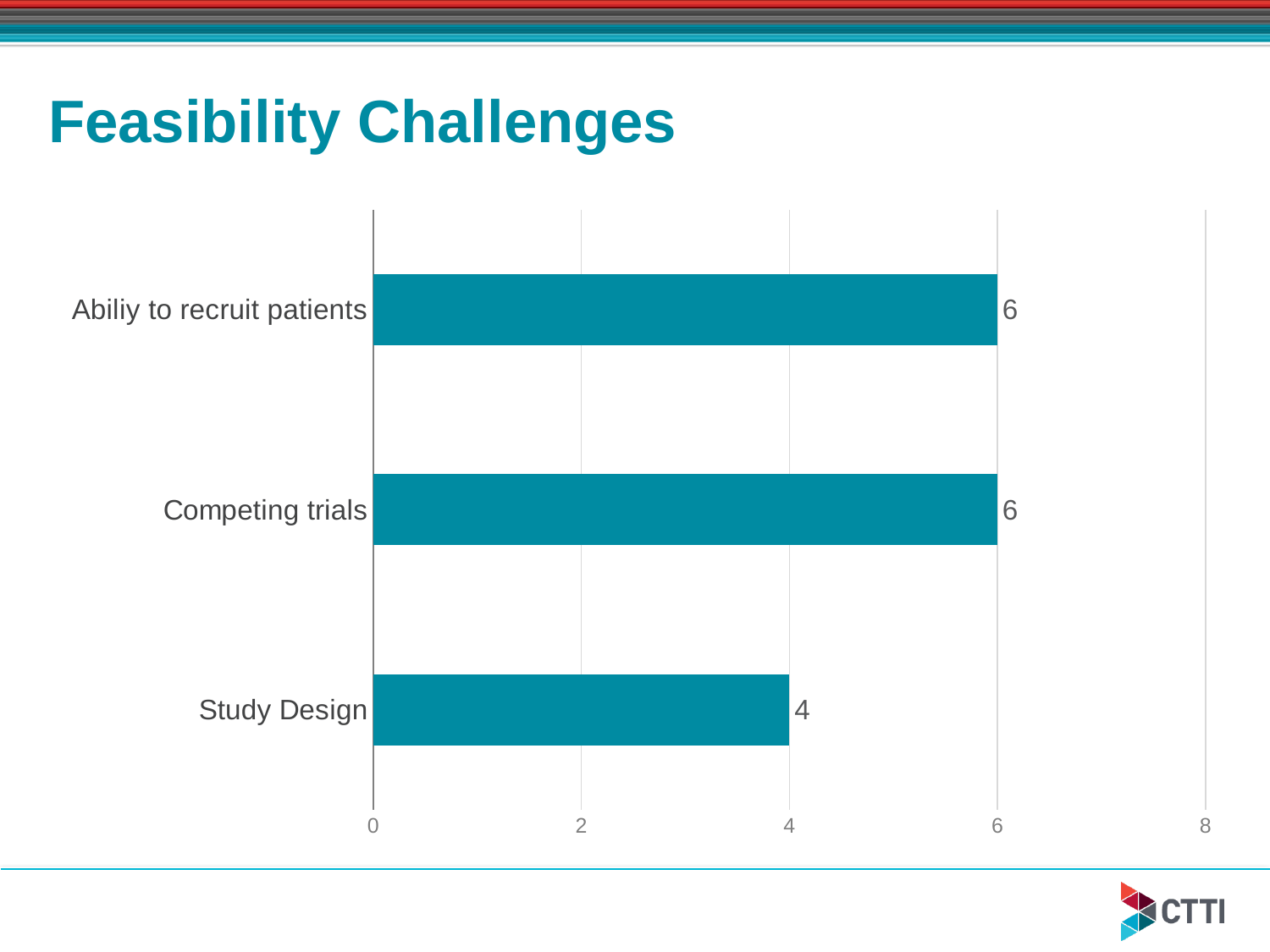
Which category has the lowest value? Study Design Is the value for Study Design greater or less than 6? less What kind of chart is shown on the slide? bar chart What is the value for Abiliy to recruit patients? 6 What is the value for Competing trials? 6 What is the title of the slide? Feasibility Challenges What is the maximum value shown on the horizontal axis? 8 What is the value for Study Design? 4 Which is larger, the value for Abiliy to recruit patients or the value for Study Design? Abiliy to recruit patients How many categories are shown in the chart? 3 What is the difference between the values for Competing trials and Study Design? 2